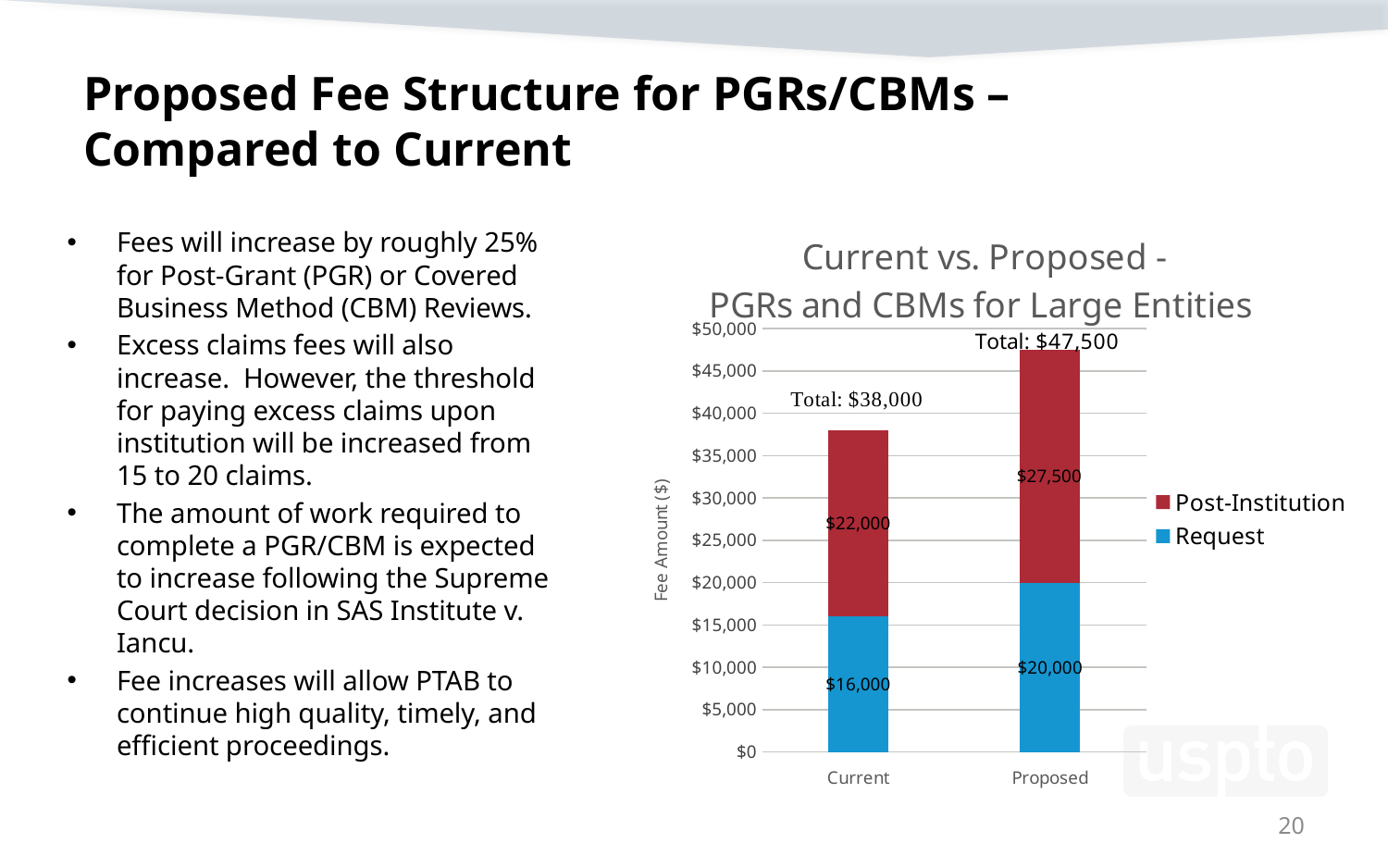
What is the difference between the Proposed and Current Post-Institution fees? $5,500 What kind of chart is shown on the slide? Stacked bar chart Which category has the higher total fee, Current or Proposed? Proposed How many series does the legend list? 2 What is the Post-Institution fee for the Proposed category? $27,500 What is the Request fee for the Current category? $16,000 How many categories are shown on the x axis? 2 What is the total fee for the Current stacked bar? $38,000 What is the title of the chart? Current vs. Proposed - PGRs and CBMs for Large Entities What is the total fee for the Proposed stacked bar? $47,500 What is the difference between the Proposed and Current Request fees? $4,000 What is the Post-Institution fee for the Current category? $22,000